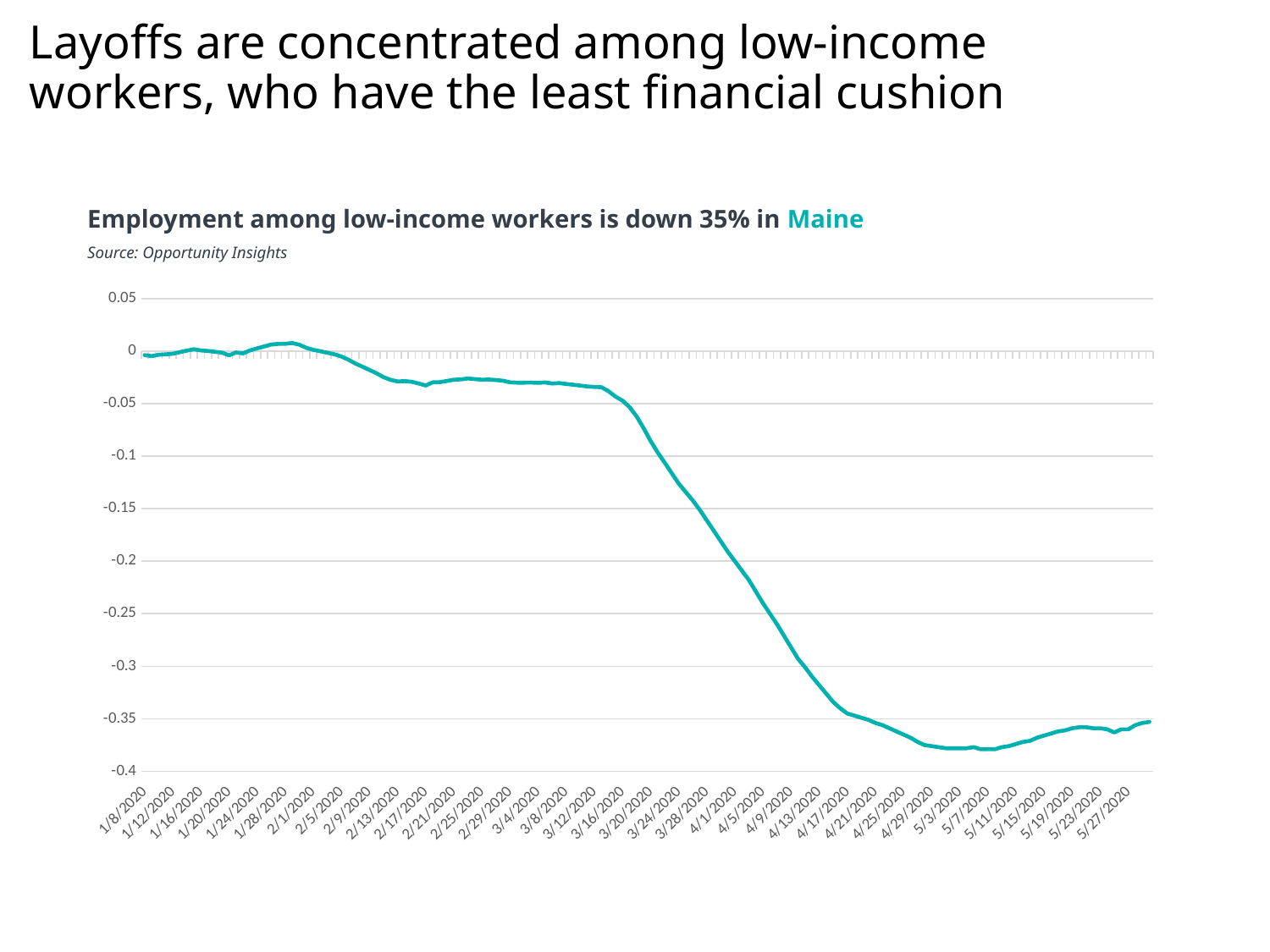
Is the value for 3/24/2020 greater or less than -0.1? less Is the value for 3/12/2020 greater or less than -0.05? greater Is the value for 5/3/2020 greater or less than -0.35? less How many date labels are shown along the x axis? 36 Is the value for 3/12/2020 larger than the value for 4/13/2020? yes What kind of chart is shown on the slide? line chart Overall, does the line rise or fall from 1/8/2020 to 5/27/2020? fall According to the chart title, by what percentage is employment among low-income workers down in Maine? 35% What is the source cited for the chart? Opportunity Insights Between 3/16/2020 and 4/17/2020, does the line rise or fall? fall